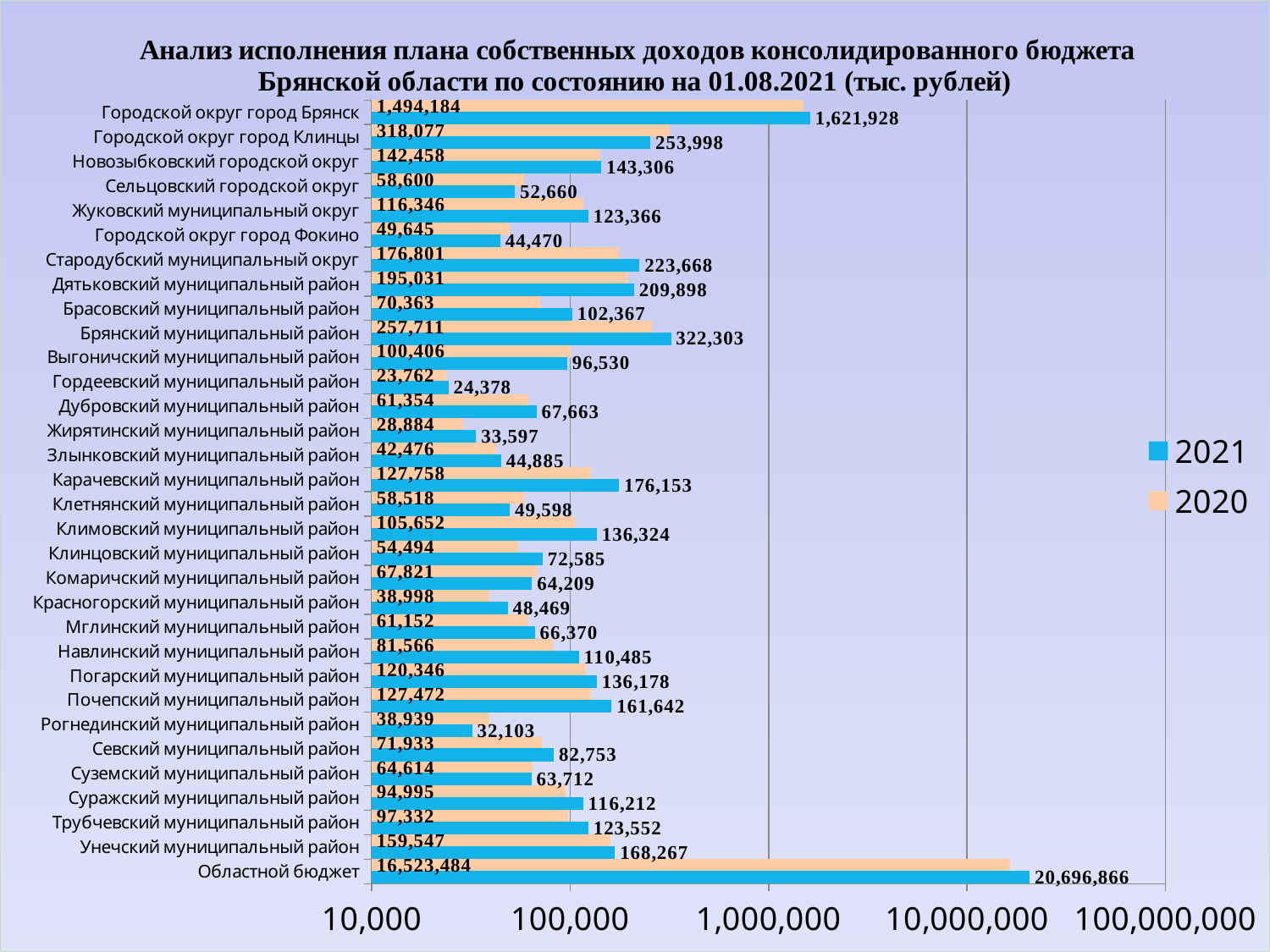
What is the 2020 value for Областной бюджет? 16,523,484 For Городской округ город Клинцы, which year has the larger value, 2020 or 2021? 2020 How many series does the legend list? 2 What is the difference between the 2021 and 2020 values for Городской округ город Брянск? 127,744 What is the difference between the 2021 and 2020 values for Областной бюджет? 4,173,382 What is the 2020 value for Карачевский муниципальный район? 127,758 Which category has the highest 2021 value? Областной бюджет How many categories are shown on the chart? 32 Which category has the lowest 2021 value? Гордеевский муниципальный район Which colour represents the 2021 series in the legend? blue What kind of chart is shown on the slide? bar chart What is the 2021 value for Городской округ город Брянск? 1,621,928